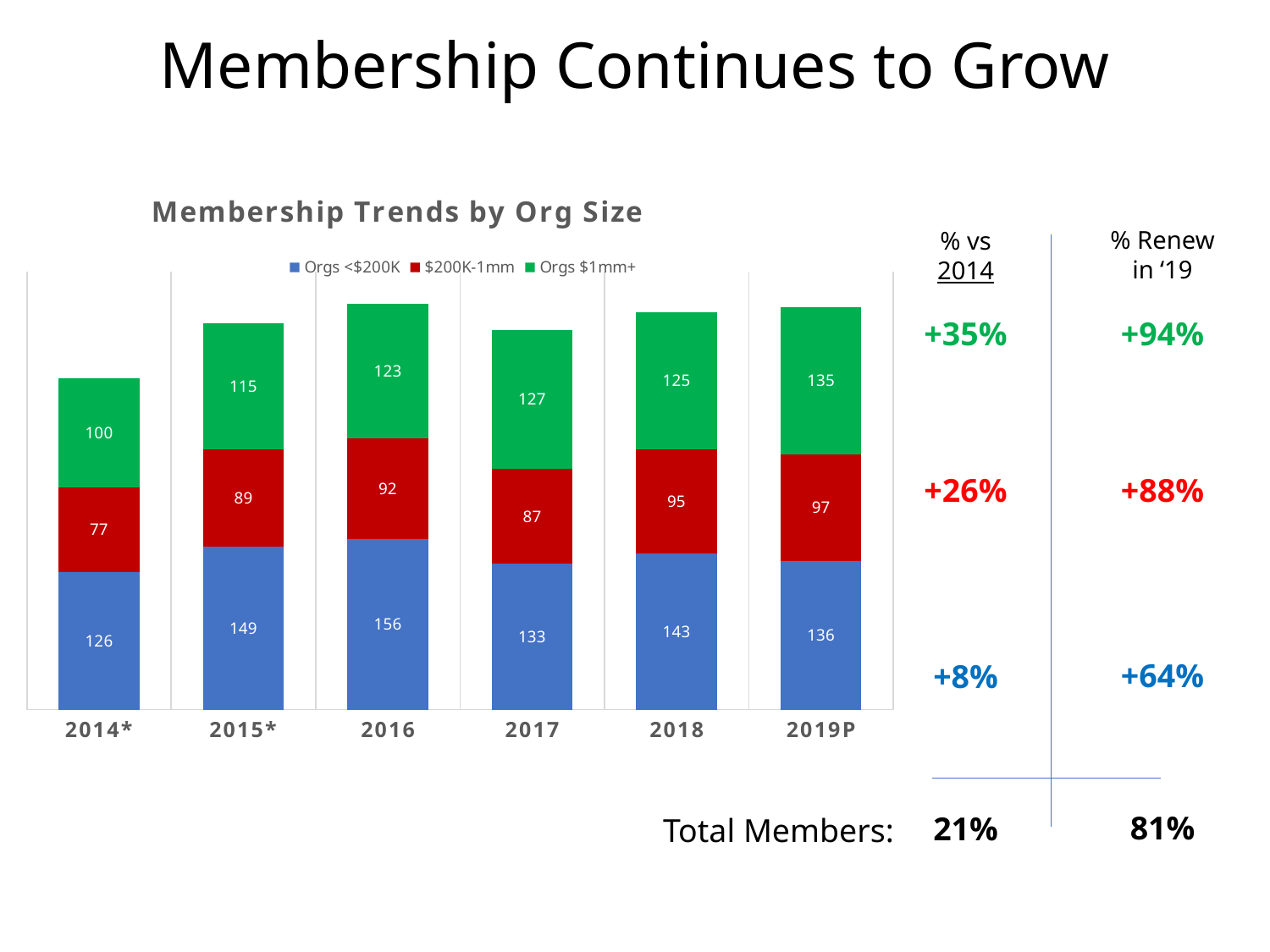
How many series does the legend list? 3 Which year has the highest value for Orgs <$200K? 2016 What is the value for Orgs $1mm+ in 2019P? 135 What is the value for Orgs <$200K in 2016? 156 How many years are shown on the x axis? 6 Which is larger: the $200K-1mm value in 2018 or in 2017? 2018 What is the difference between the Orgs <$200K values in 2015* and 2014*? 23 What kind of chart is shown? stacked bar chart What is the total of the stacked bar for 2014*? 303 What is the value for $200K-1mm in 2014*? 77 What is the title of the chart? Membership Trends by Org Size Which year has the lowest value for Orgs $1mm+? 2014*